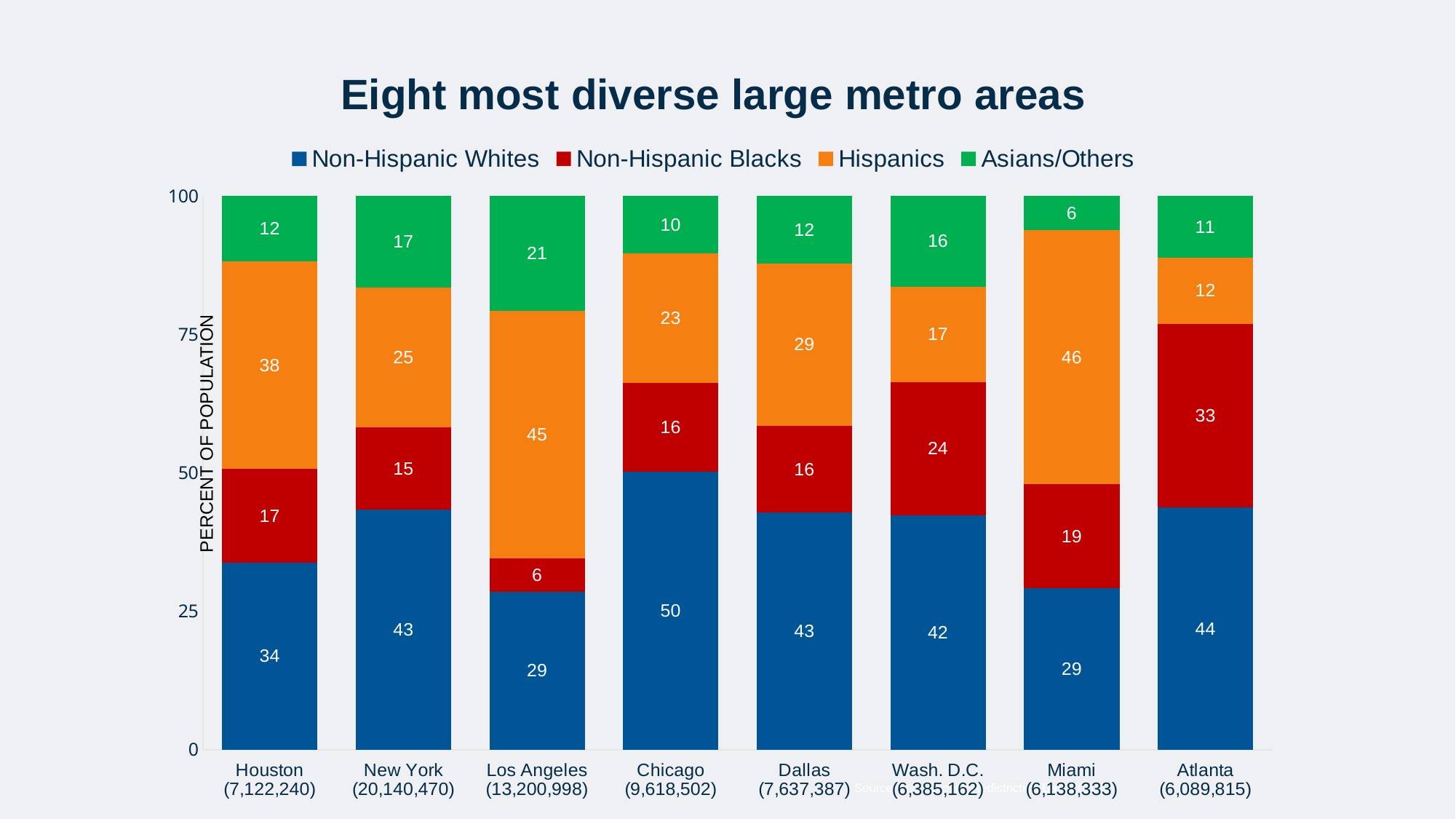
What is the Asians/Others value for Los Angeles? 21 What kind of chart is shown on the slide? Stacked bar chart Which metro area has the highest Non-Hispanic Blacks value? Atlanta What is the Non-Hispanic Whites value for Chicago? 50 Which metro area has the lowest Asians/Others value? Miami How many series does the legend list? 4 What is the Non-Hispanic Blacks value for Wash. D.C.? 24 Which metro area has the highest Hispanics value? Miami What is the Hispanics value for Miami? 46 What is the difference between the Hispanics values for Los Angeles and Atlanta? 33 Which has a larger Non-Hispanic Whites value, New York or Houston? New York How many metro areas are shown on the x axis? 8